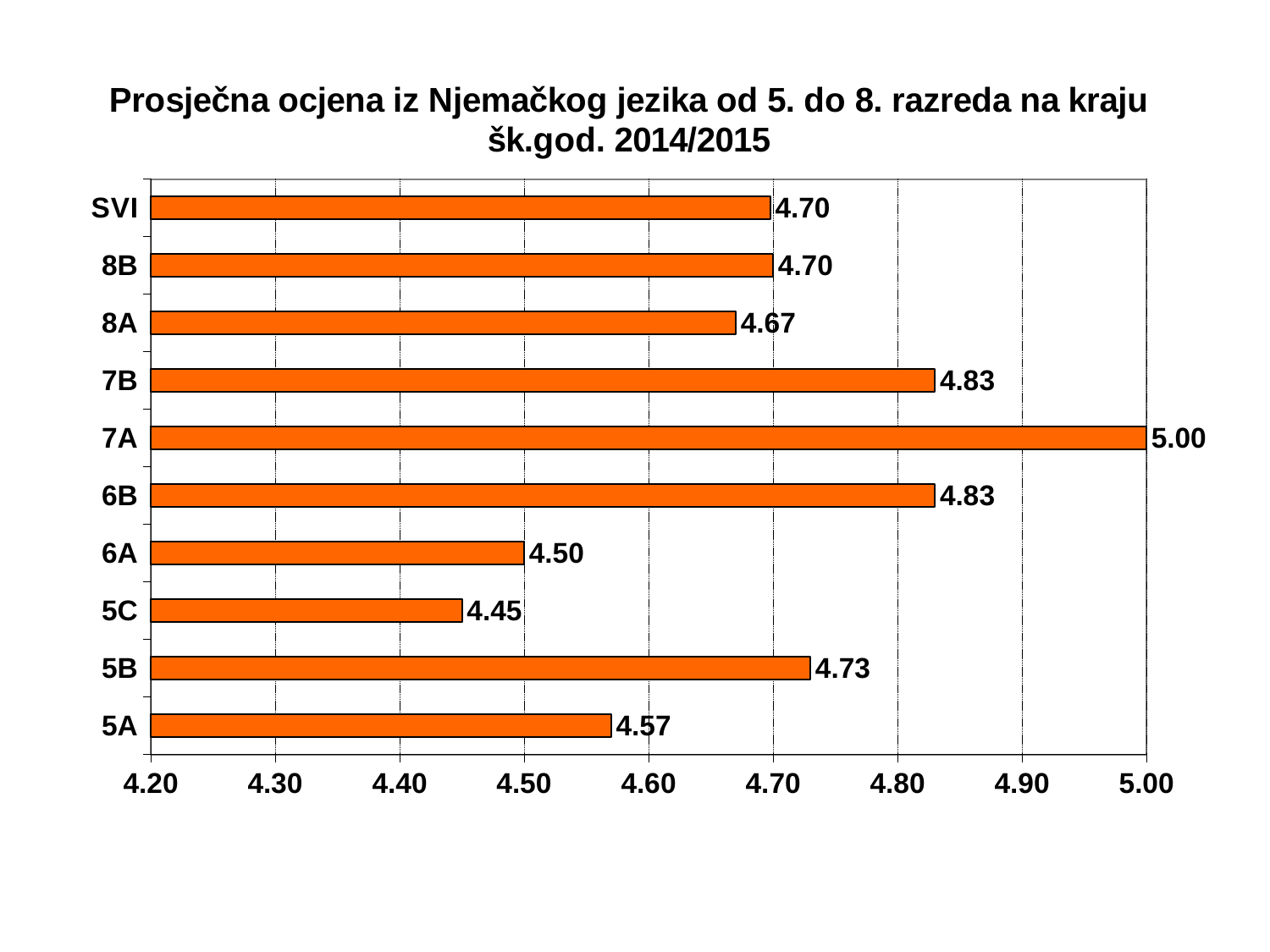
What is the value for SVI? 4.70 What is the value for 5C? 4.45 Which category has the highest value? 7A What is the title of the chart? Prosječna ocjena iz Njemačkog jezika od 5. do 8. razreda na kraju šk.god. 2014/2015 Which is larger, the value for 5B or the value for 5A? 5B What is the value for 7A? 5.00 How many categories are shown on the chart? 10 What kind of chart is this? bar chart Is the value for 6A greater or less than 4.60? less Which category has the lowest value? 5C What is the difference between the values for 7B and 8A? 0.16 What is the difference between the values for 7A and 5C? 0.55